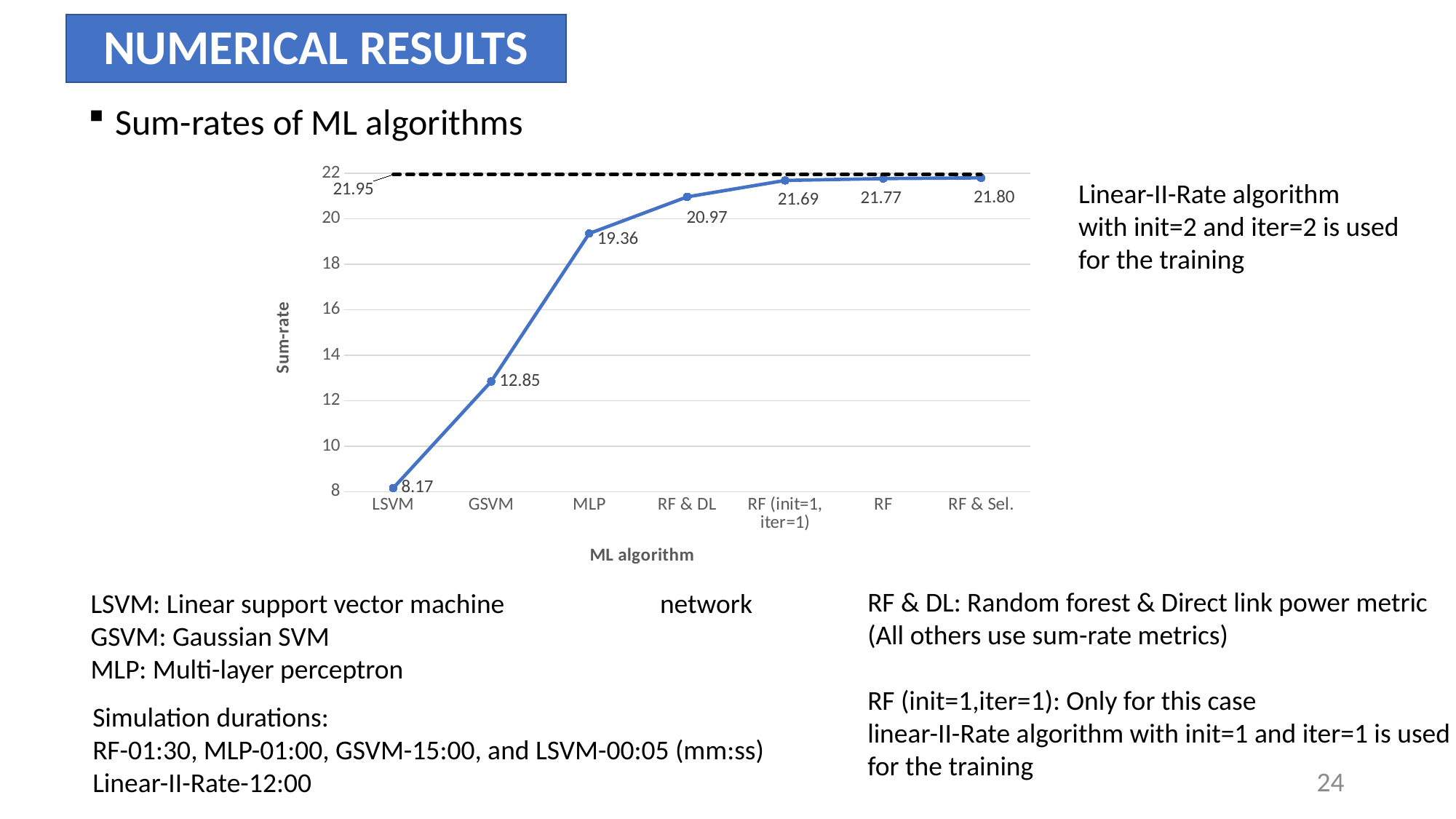
What is the sum-rate for LSVM? 8.17 What is the sum-rate for RF (init=1, iter=1)? 21.69 Which has a higher sum-rate, MLP or RF & DL? RF & DL Is the sum-rate for GSVM greater or less than 14? less What is the sum-rate for RF & DL? 20.97 What is the sum-rate for MLP? 19.36 What kind of chart is shown on the slide? line chart How many ML algorithms are plotted on the x axis? 7 What is the difference in sum-rate between MLP and GSVM? 6.51 Which ML algorithm has the lowest sum-rate? LSVM What is the difference in sum-rate between GSVM and LSVM? 4.68 Do the sum-rate values rise or fall from LSVM to RF & Sel. along the x axis? rise